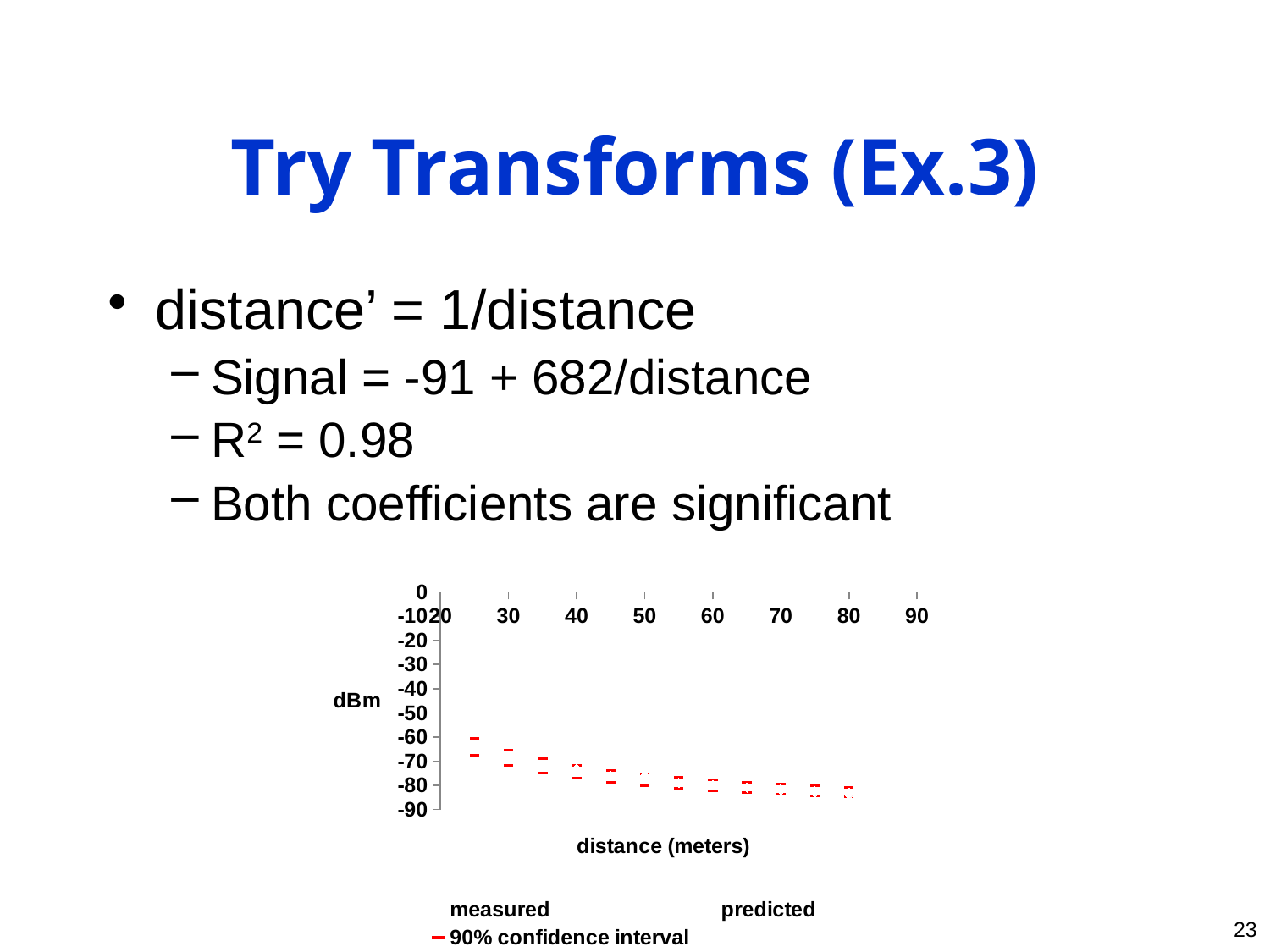
Is the plotted dBm value at a distance of about 25 meters greater or less than -50? less Is the plotted dBm value at a distance of about 80 meters greater or less than -70? less How many series does the chart's legend list? 3 Is the plotted dBm value at a distance of about 25 meters greater or less than -80? greater Do the plotted dBm values rise or fall as distance increases along the x axis? fall Which has the higher plotted dBm value: the point near 25 meters or the point near 80 meters? the point near 25 meters What kind of chart is shown on the slide? scatter chart What is the label on the chart's y axis? dBm What is the highest value shown on the chart's x axis? 90 What is the label on the chart's x axis? distance (meters)